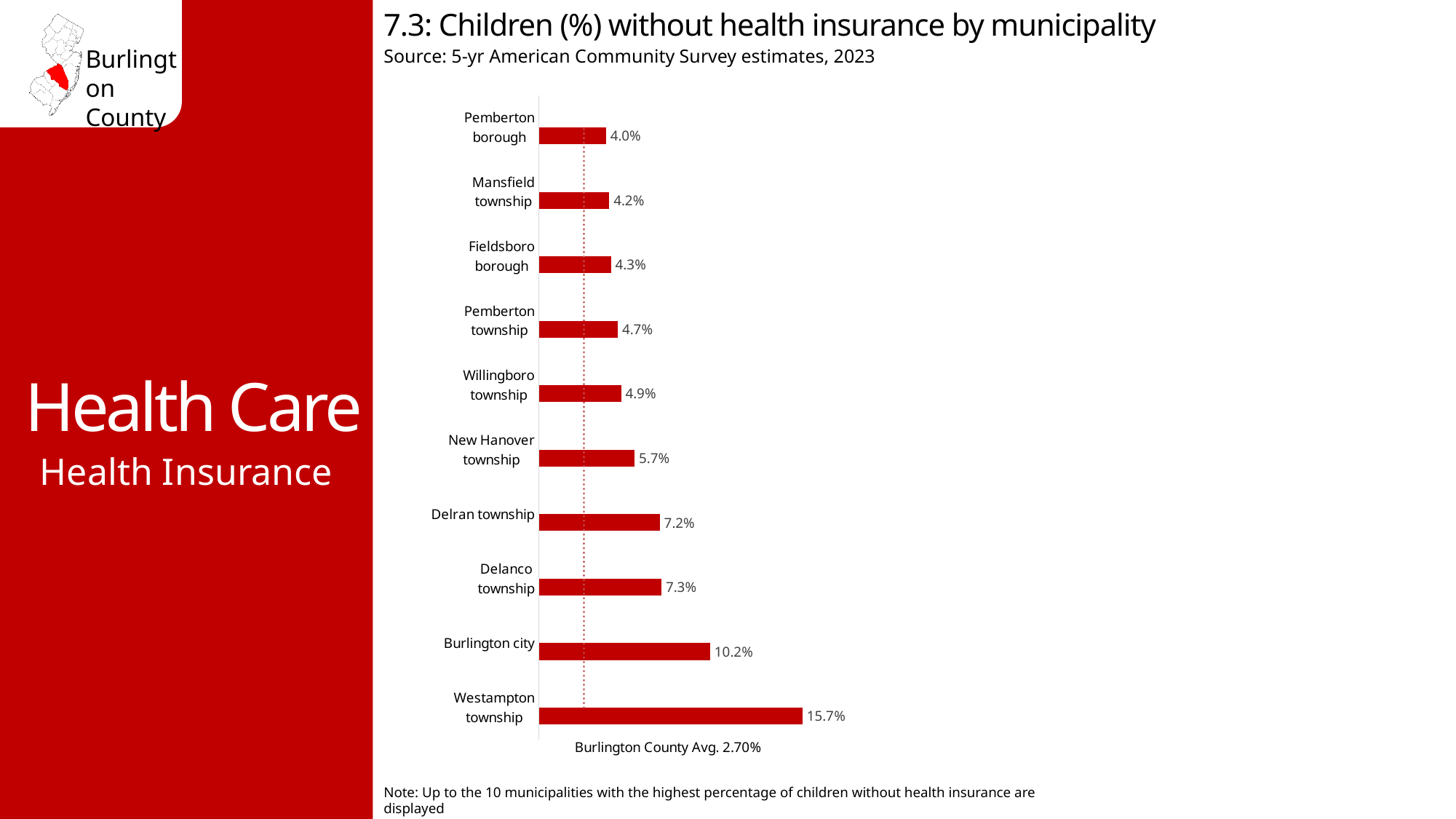
What is the difference between the values for Delran township and New Hanover township? 1.5% What percentage of children are without health insurance in Westampton township? 15.7% What is the difference between the values for Westampton township and Burlington city? 5.5% What is the source of the data shown in the chart? 5-yr American Community Survey estimates, 2023 What is the Burlington County average shown on the chart? 2.70% Which has a higher value, Pemberton township or Delanco township? Delanco township Which municipality has the lowest percentage of children without health insurance on the chart? Pemberton borough How many municipalities are shown on the chart? 10 What kind of chart is shown on the slide? Bar chart What percentage is shown for Willingboro township? 4.9% Which municipality has the highest percentage of children without health insurance? Westampton township What is the value shown for Burlington city? 10.2%